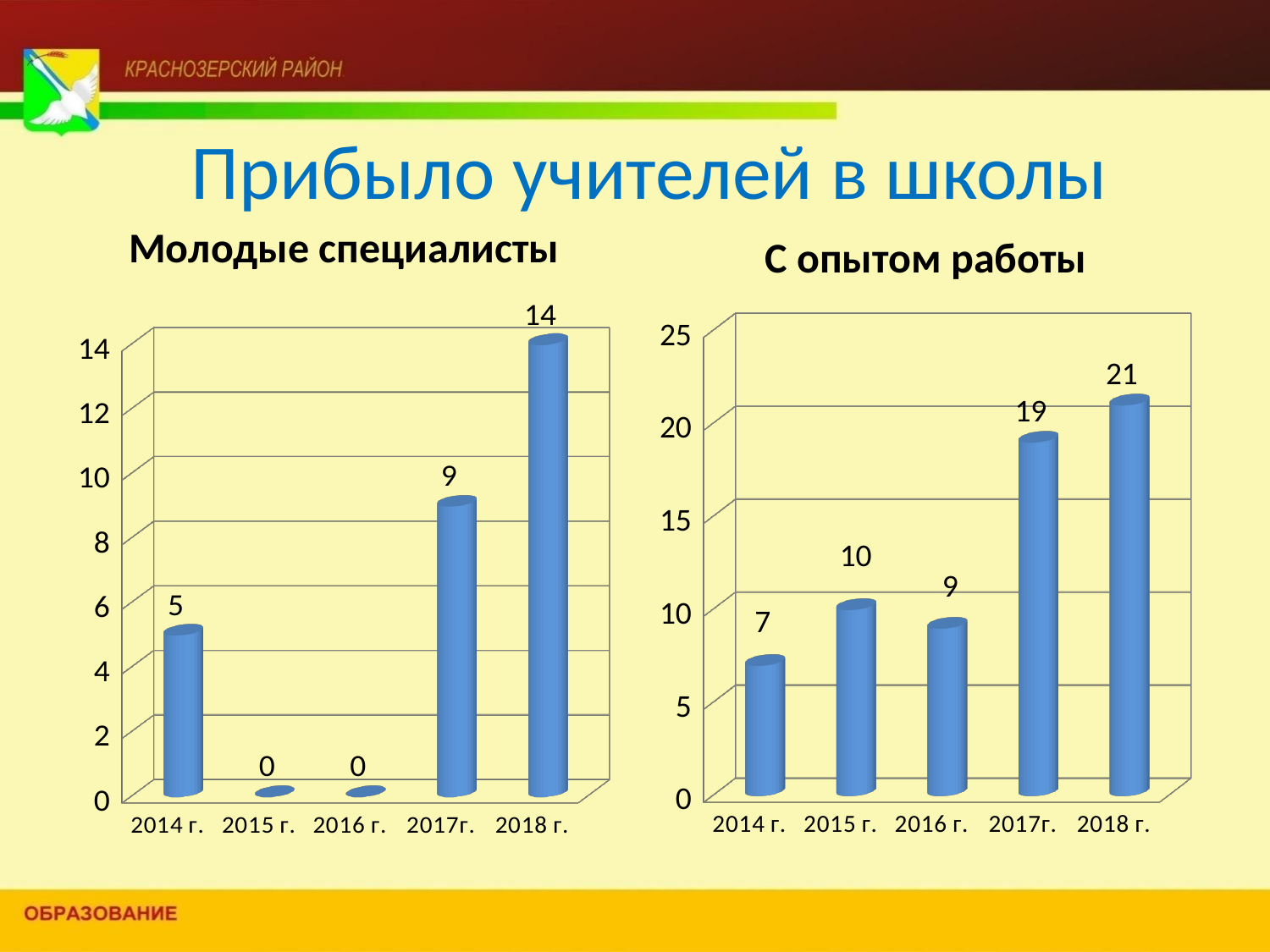
In the "С опытом работы" chart, which year has the highest value? 2018 г. In the "Молодые специалисты" chart, how many years have a value of 0? 2 In the "Молодые специалисты" chart, which year has the highest value? 2018 г. In the "Молодые специалисты" chart, what is the value for 2017г.? 9 In the "С опытом работы" chart, which year has the lowest value? 2014 г. In the "С опытом работы" chart, what is the difference between the values for 2018 г. and 2017г.? 2 In the "Молодые специалисты" chart, what is the value for 2018 г.? 14 In the "С опытом работы" chart, what is the value for 2014 г.? 7 In the "Молодые специалисты" chart, what is the difference between the values for 2018 г. and 2017г.? 5 How many years are shown on the x axis of the "Молодые специалисты" chart? 5 What kind of chart is the "С опытом работы" chart? bar chart In the "С опытом работы" chart, which is larger, the value for 2015 г. or 2016 г.? 2015 г.